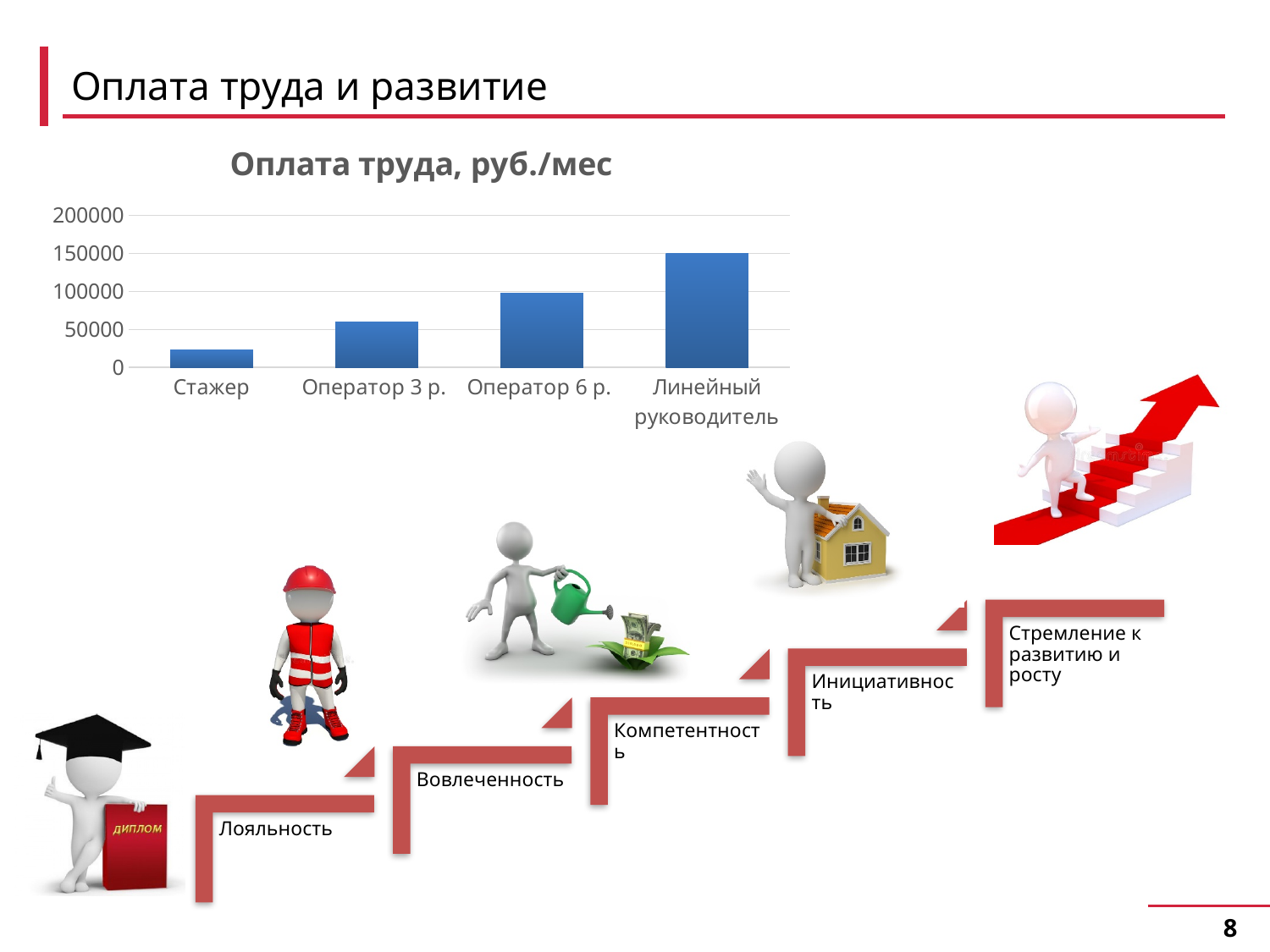
Which category has the lowest value in the chart? Стажер Which category has the highest value in the chart? Линейный руководитель Do the values rise or fall from left to right along the x axis? rise Is the value for Оператор 6 р. greater or less than 50000? greater What kind of chart is shown on the slide? bar chart Is the value for Стажер greater or less than 50000? less What is the title of the chart? Оплата труда, руб./мес Is the value for Оператор 3 р. greater or less than 50000? greater What is the highest value shown on the vertical axis of the chart? 200000 How many categories are shown on the x axis of the chart? 4 Which is larger, the value for Оператор 6 р. or the value for Оператор 3 р.? Оператор 6 р.